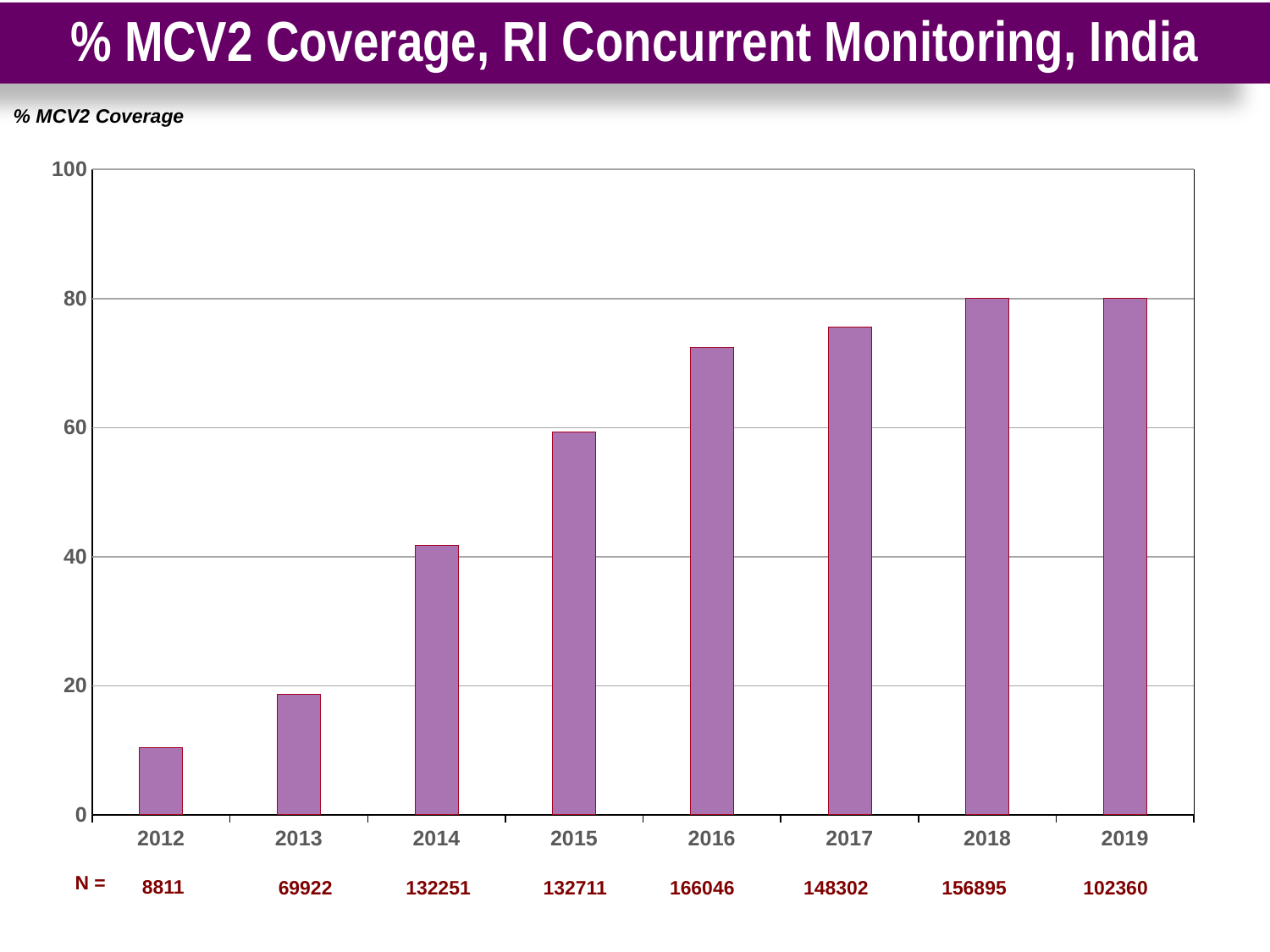
Which year has the higher % MCV2 coverage, 2014 or 2015? 2015 How many years are shown on the x axis of the chart? 8 What is the N value printed below the chart for 2016? 166046 Is the % MCV2 coverage for 2012 greater or less than 20? less What kind of chart is shown on the slide? bar chart Is the % MCV2 coverage for 2013 greater or less than 20? less Is the % MCV2 coverage for 2017 greater or less than 80? less Which year has the lowest % MCV2 coverage? 2012 Does the % MCV2 coverage generally rise or fall from 2012 to 2019? rise What is the title of the chart on the slide? % MCV2 Coverage, RI Concurrent Monitoring, India